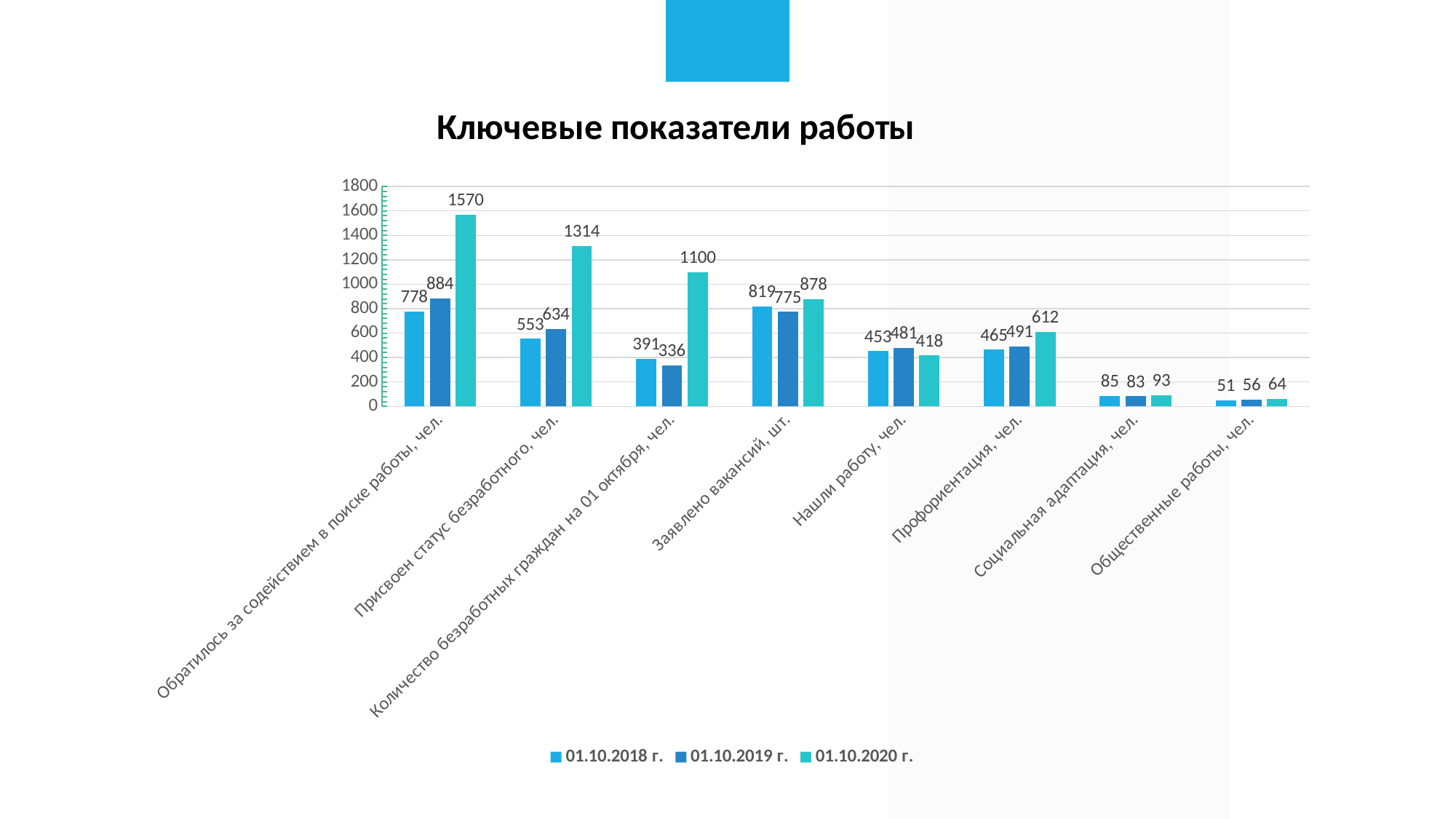
What kind of chart is shown on the slide? Bar chart What is the value for "Обратилось за содействием в поиске работы, чел." in the 01.10.2020 г. series? 1570 What is the title of the chart? Ключевые показатели работы Which category has the highest value in the 01.10.2020 г. series? Обратилось за содействием в поиске работы, чел. How many categories are shown on the x axis? 8 For "Нашли работу, чел.", which is larger: the 01.10.2019 г. value or the 01.10.2020 г. value? 01.10.2019 г. Which category has the lowest value in the 01.10.2018 г. series? Общественные работы, чел. What is the difference between the 01.10.2020 г. and 01.10.2019 г. values for "Присвоен статус безработного, чел."? 680 How many series does the legend list? 3 What is the value for "Социальная адаптация, чел." in the 01.10.2018 г. series? 85 What is the value for "Заявлено вакансий, шт." in the 01.10.2019 г. series? 775 What is the difference between the 01.10.2018 г. and 01.10.2019 г. values for "Количество безработных граждан на 01 октября, чел."? 55